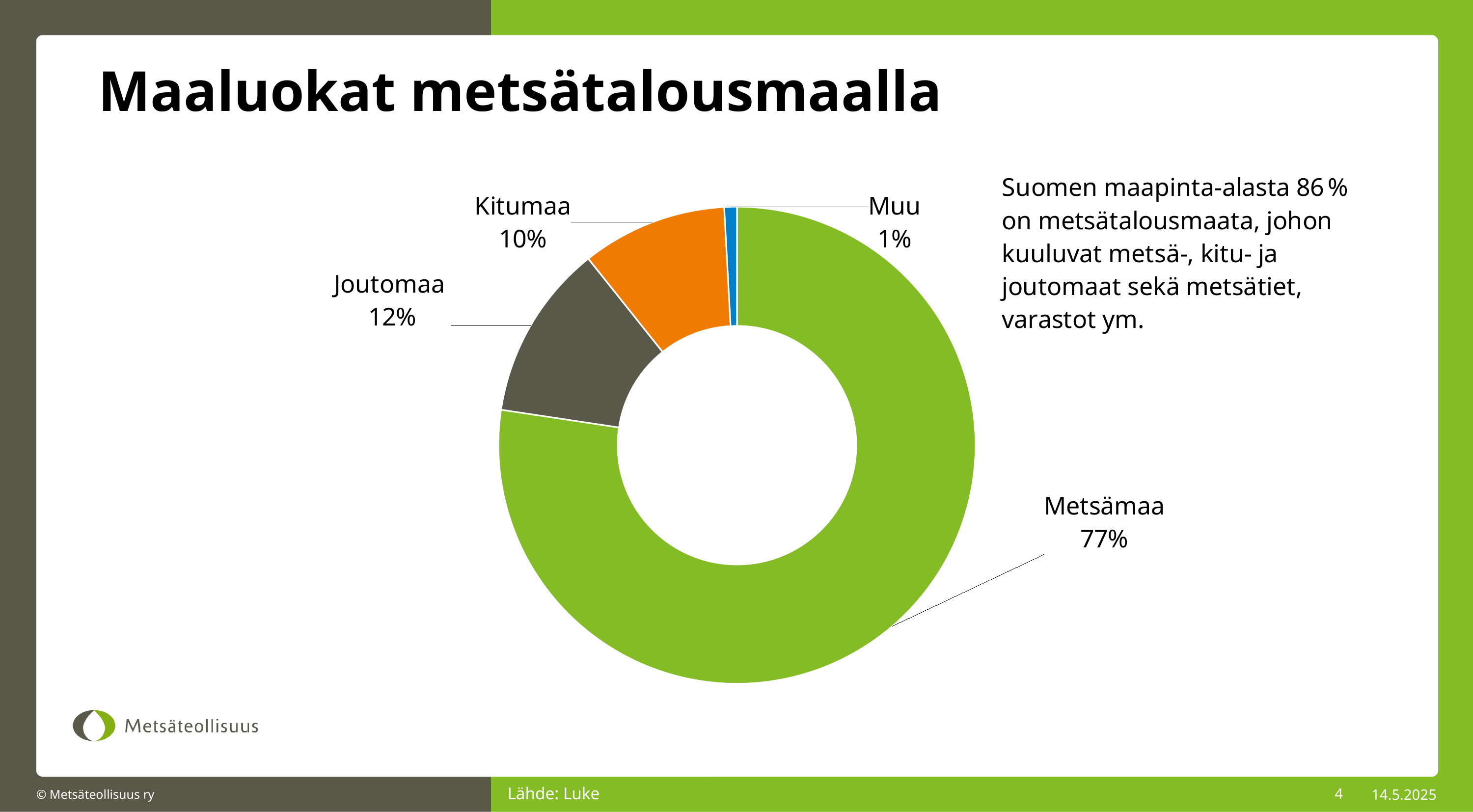
What colour is the Kitumaa slice? Orange What is the value shown for Joutomaa? 12% How many categories are shown in the chart? 4 What share of the chart does Metsämaa represent? 77% Which is larger, the share of Kitumaa or the share of Muu? Kitumaa Which category has the largest share of the chart? Metsämaa What is the difference between the shares of Joutomaa and Kitumaa? 2% What is the value shown for Kitumaa? 10% What kind of chart is shown on the slide? Doughnut (pie) chart Which category has the smallest share of the chart? Muu What is the value shown for Muu? 1% What is the difference between the shares of Metsämaa and Joutomaa? 65%